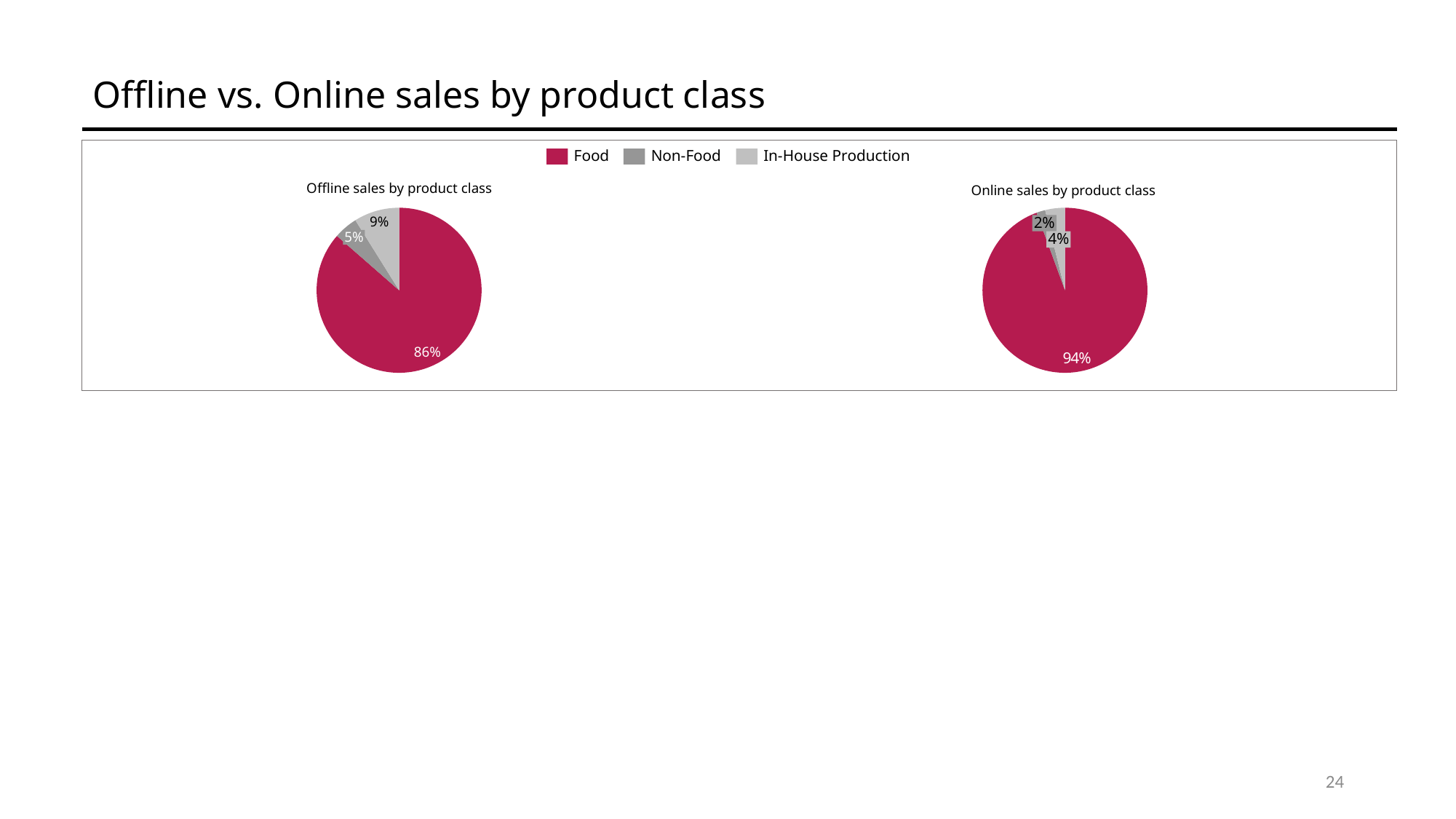
In the Online sales by product class chart, which product class has the largest share? Food In the Offline sales by product class chart, which product class has the smallest share? Non-Food How many product classes does the legend list? 3 In the Offline sales by product class chart, what share of sales is Non-Food? 5% In the Online sales by product class chart, what share of sales is Food? 94% In the Offline sales by product class chart, what share of sales is In-House Production? 9% In the Online sales by product class chart, what share of sales is Non-Food? 2% In the Offline sales by product class chart, what share of sales is Food? 86% Is the In-House Production share larger in the Offline chart or the Online chart? Offline What is the difference between the Food share in the Online chart and the Food share in the Offline chart? 8 percentage points What type of chart is used for Offline sales by product class? Pie chart In the Online sales by product class chart, what share of sales is In-House Production? 4%